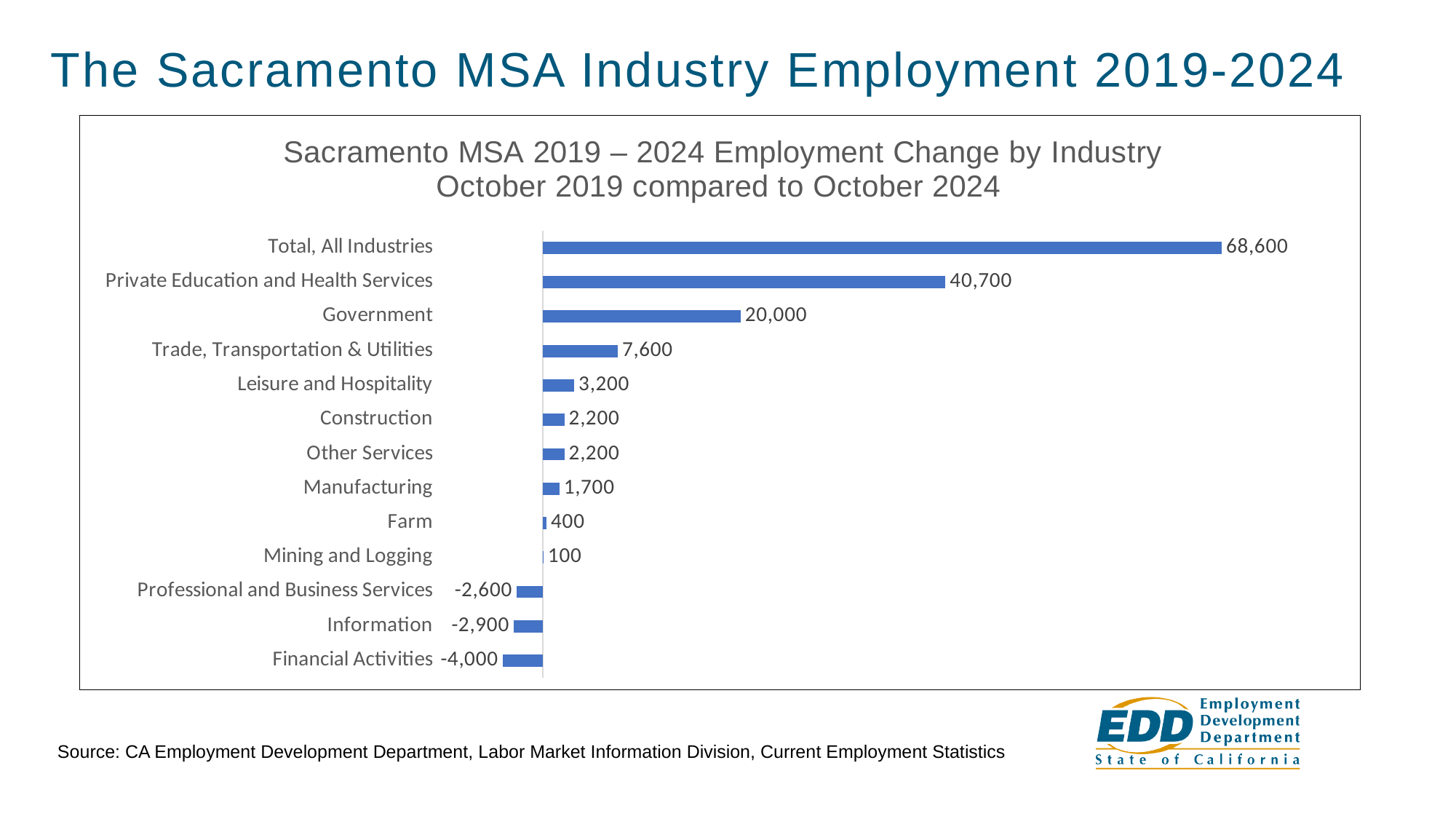
What is the employment change for Private Education and Health Services? 40,700 What is the employment change for Government? 20,000 What is the title of the chart? Sacramento MSA 2019 – 2024 Employment Change by Industry October 2019 compared to October 2024 What is the difference between the employment change for Information and Professional and Business Services? 300 What is the employment change for Financial Activities? -4,000 What is the difference between the employment change for Private Education and Health Services and Government? 20,700 How many categories are shown on the chart? 13 Which has a larger employment change, Trade, Transportation & Utilities or Leisure and Hospitality? Trade, Transportation & Utilities What is the employment change for Mining and Logging? 100 Which industry has the lowest employment change? Financial Activities Which category has the highest value on the chart? Total, All Industries What kind of chart is shown on the slide? Bar chart